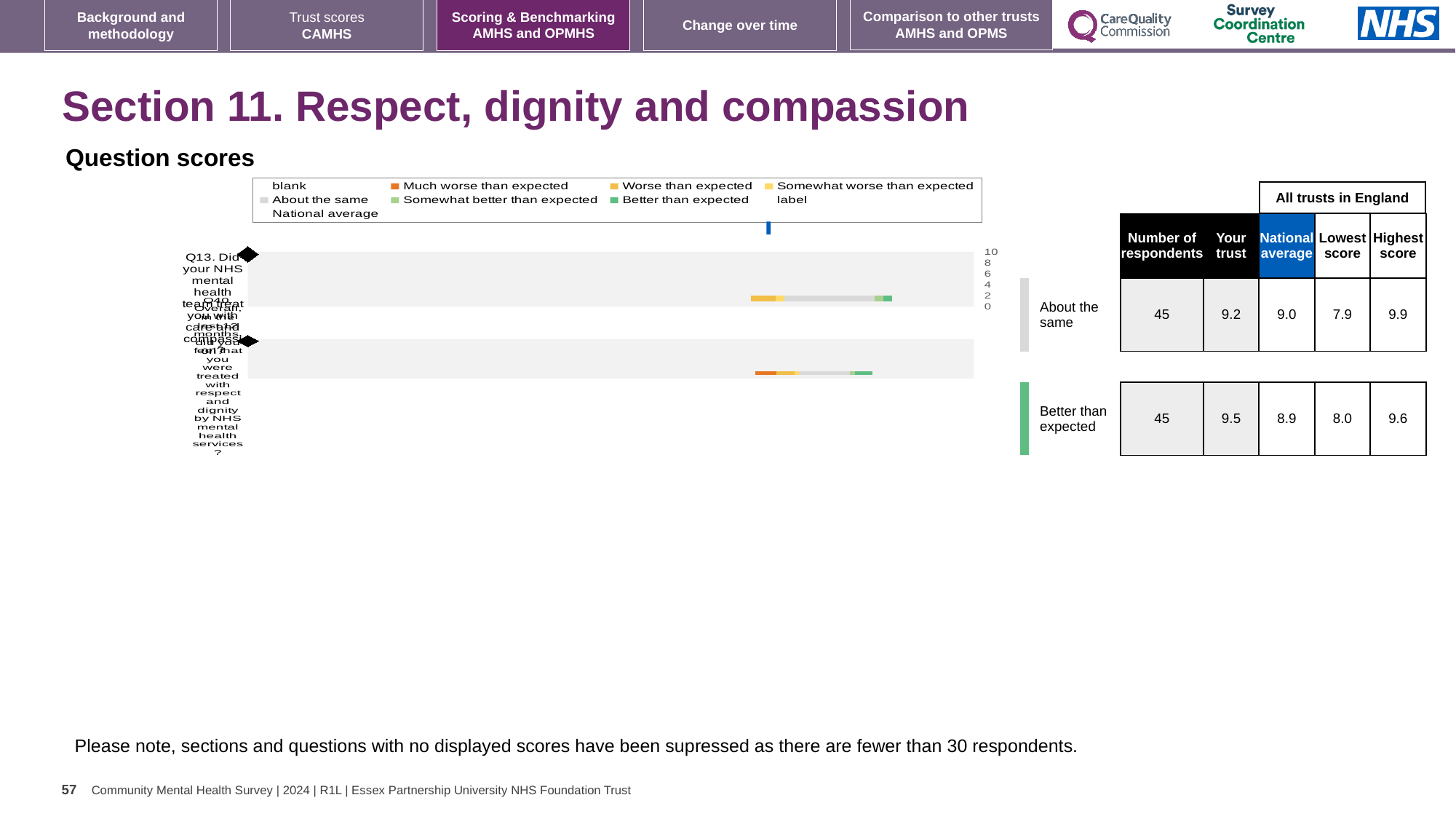
What is the national average score shown for the question rated 'About the same'? 9.0 What colour does the legend use for 'Better than expected'? green How many respondents are shown for the question rated 'Better than expected'? 45 In the table next to the chart, what is the 'Your trust' score for the first question (Q13), rated 'About the same'? 9.2 What is the lowest score across all trusts in England for the question rated 'Better than expected'? 8.0 In the table next to the chart, what is the 'Your trust' score for the second question (Q10), rated 'Better than expected'? 9.5 What is the highest score across all trusts in England for the question rated 'About the same'? 9.9 What is the difference between the trust score and the national average for the question rated 'Better than expected'? 0.6 What is the national average score shown for the question rated 'Better than expected'? 8.9 How many questions are plotted in the question scores chart? 2 Which is larger for the question rated 'About the same': the trust score or the national average? the trust score What kind of chart is used to show the question scores on this slide? bar chart